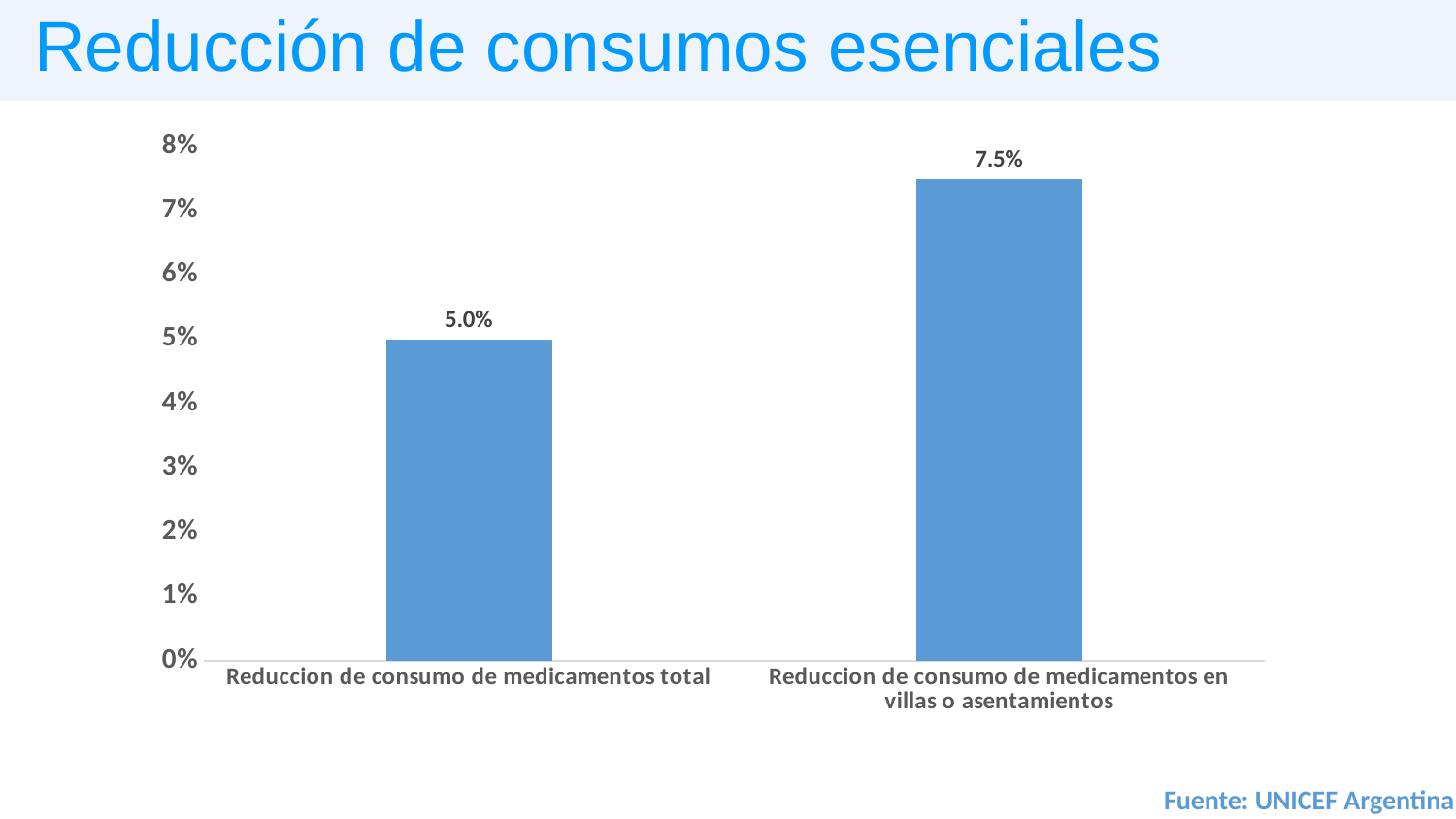
What kind of chart is shown on the slide? Bar chart Is the value for 'Reduccion de consumo de medicamentos total' greater or less than 6%? less What is the title of the slide? Reducción de consumos esenciales What is the value for 'Reduccion de consumo de medicamentos total'? 5.0% Is the value for 'Reduccion de consumo de medicamentos en villas o asentamientos' greater or less than 7%? greater How many categories are shown in the chart? 2 Which category has the highest value? Reduccion de consumo de medicamentos en villas o asentamientos What is the value for 'Reduccion de consumo de medicamentos en villas o asentamientos'? 7.5% What source is cited for the chart? UNICEF Argentina Which is larger: the value for 'Reduccion de consumo de medicamentos total' or the value for 'Reduccion de consumo de medicamentos en villas o asentamientos'? Reduccion de consumo de medicamentos en villas o asentamientos Which category has the lowest value? Reduccion de consumo de medicamentos total What is the difference between the value for 'Reduccion de consumo de medicamentos en villas o asentamientos' and the value for 'Reduccion de consumo de medicamentos total'? 2.5%